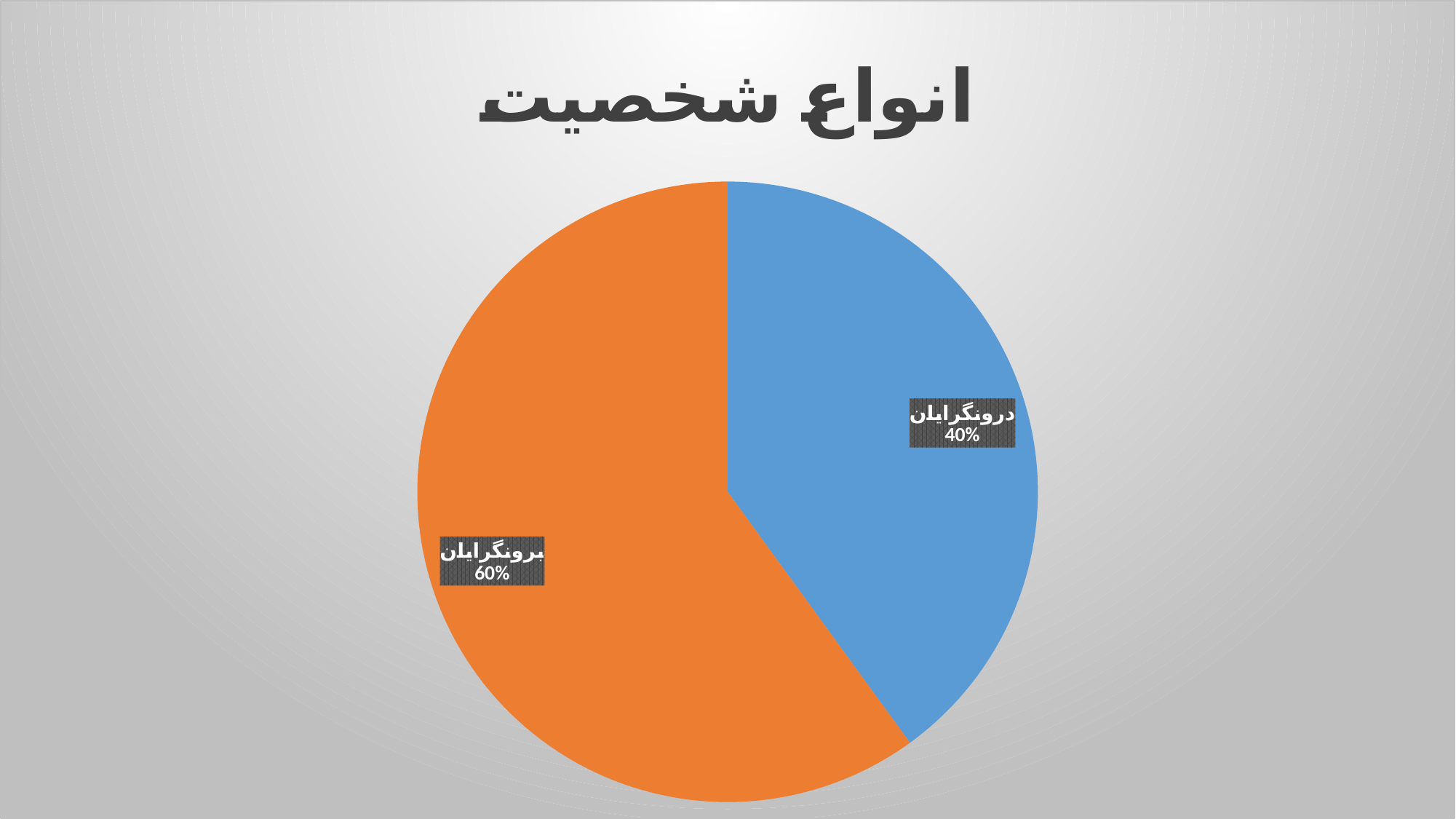
What is the difference in percentage points between برونگرایان and درونگرایان? 20% Is the share for درونگرایان greater or less than 50%? less What share of the pie does درونگرایان have? 40% Which slice is the largest? برونگرایان What share of the pie does برونگرایان have? 60% How many slices does the pie chart have? 2 Which is larger, برونگرایان or درونگرایان? برونگرایان What colour is the درونگرایان slice? blue Which slice is the smallest? درونگرایان What is the title of the chart? انواع شخصیت What kind of chart is shown on the slide? pie chart